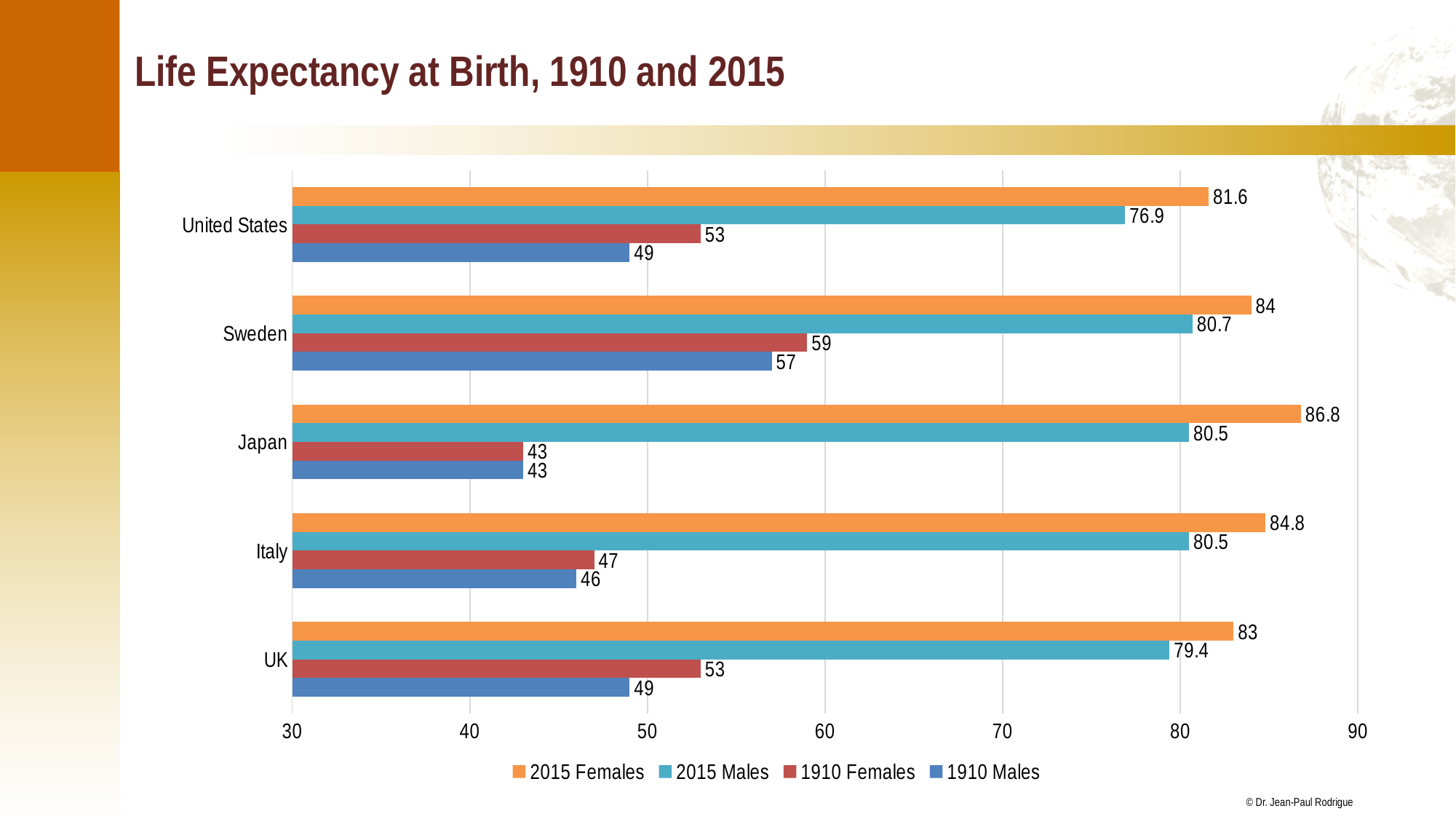
What is the difference between the 2015 Females and 1910 Females life expectancy for the UK? 30 Which country has the highest 2015 Females life expectancy? Japan What is the title of the slide? Life Expectancy at Birth, 1910 and 2015 Which country has the lowest 1910 Females life expectancy? Japan How many countries are shown on the chart? 5 What kind of chart is shown on the slide? bar chart How many series does the legend list? 4 What is the 2015 Females life expectancy for Japan? 86.8 What is the 2015 Males life expectancy for the United States? 76.9 Which is larger, the 2015 Males life expectancy for Sweden or for the UK? Sweden Is the 1910 Males life expectancy for Italy greater or less than 50? less What is the 1910 Males life expectancy for Sweden? 57